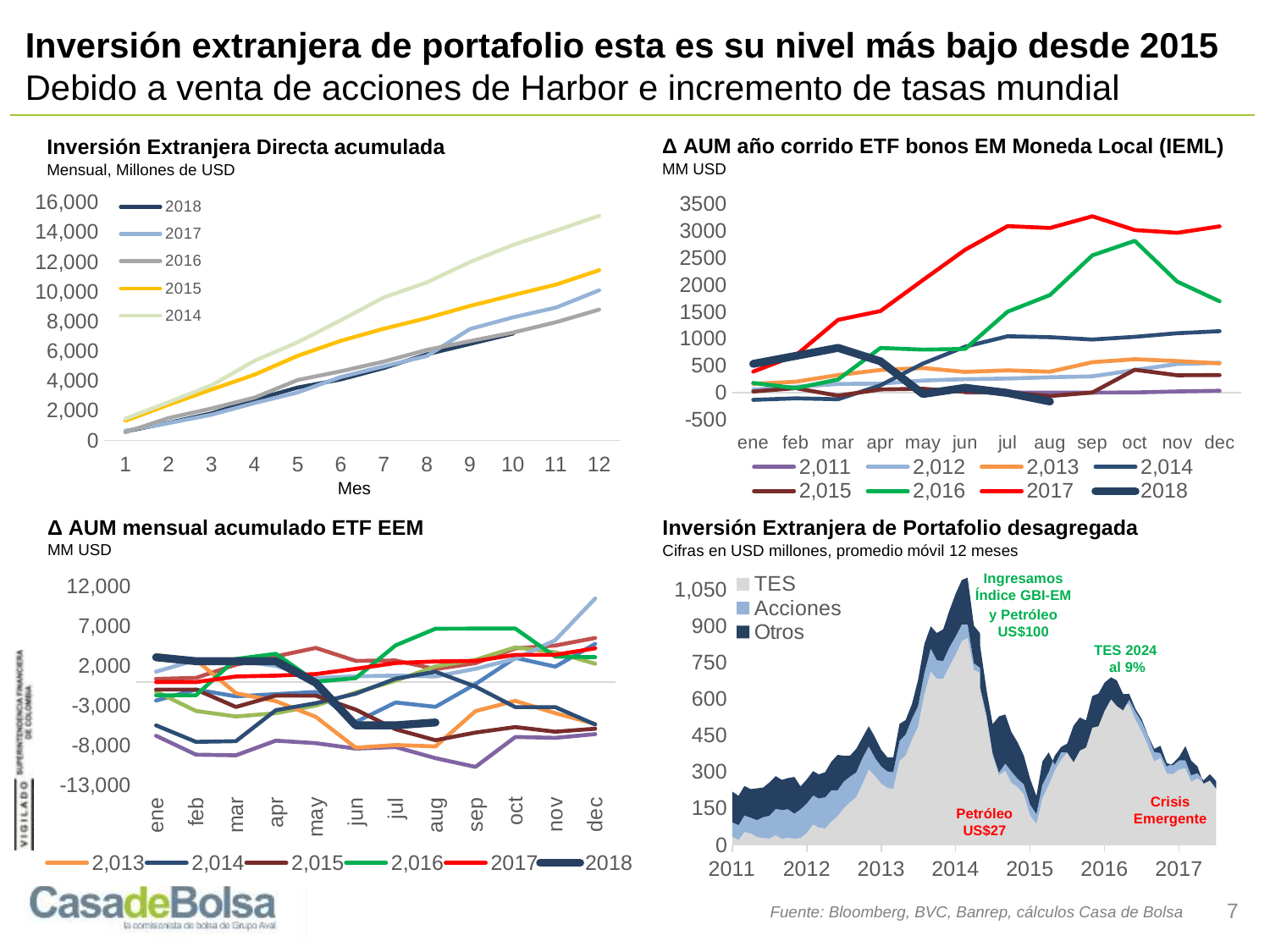
In the chart titled 'Inversión Extranjera Directa acumulada', what kind of chart is it? line chart In the chart titled 'Inversión Extranjera Directa acumulada', how many series does the legend list? 5 In the chart titled 'Inversión Extranjera de Portafolio desagregada', what are the three series listed in the legend? TES, Acciones, Otros In the chart titled 'Δ AUM mensual acumulado ETF EEM', is the value for 2014 in dec greater or less than 7,000? less In the chart titled 'Δ AUM mensual acumulado ETF EEM', how many series does the legend list? 6 In the chart titled 'Δ AUM año corrido ETF bonos EM Moneda Local (IEML)', which year has the highest value in dec? 2017 In the chart titled 'Δ AUM año corrido ETF bonos EM Moneda Local (IEML)', is the value for 2017 in sep greater or less than 3000? greater In the chart titled 'Δ AUM año corrido ETF bonos EM Moneda Local (IEML)', which is larger in dec: 2016 or 2014? 2016 In the chart titled 'Inversión Extranjera Directa acumulada', is the value for 2014 at month 12 greater or less than 14,000? greater In the chart titled 'Inversión Extranjera Directa acumulada', do the values for 2015 rise or fall from month 1 to month 12? rise In the chart titled 'Inversión Extranjera Directa acumulada', which year has the highest value at month 12? 2014 In the chart titled 'Δ AUM año corrido ETF bonos EM Moneda Local (IEML)', how many series does the legend list? 8